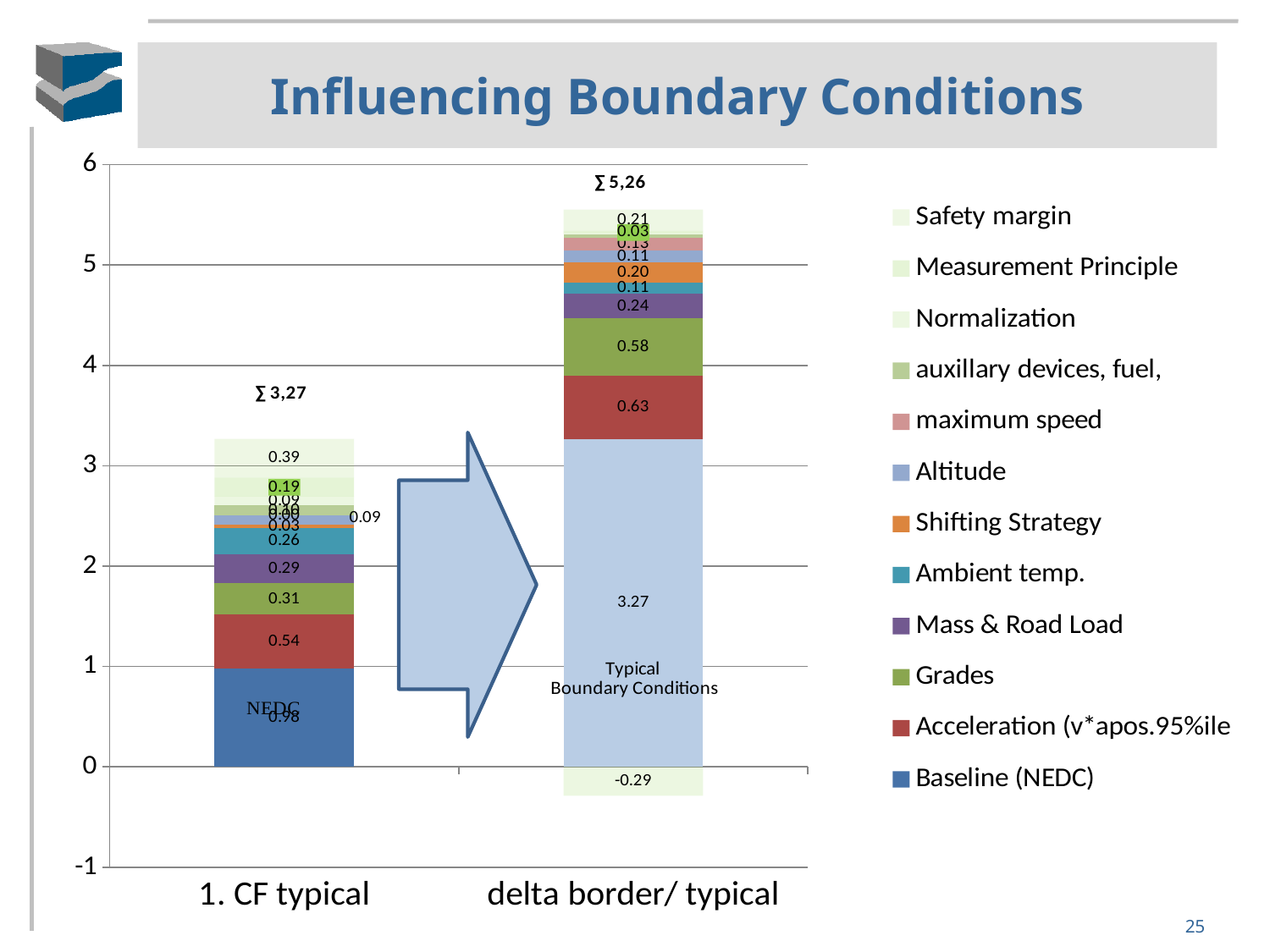
What is the difference between the Grades segment in the "delta border/ typical" bar and the Grades segment in the "1. CF typical" bar? 0.27 What is the value of the Baseline (NEDC) segment in the "1. CF typical" bar? 0.98 What is the value of the Grades segment in the "delta border/ typical" bar? 0.58 What is the value of the Acceleration segment in the "1. CF typical" bar? 0.54 What is the value of the Safety margin segment in the "1. CF typical" bar? 0.39 How many bars (categories) are shown on the x axis? 2 What is the total shown above the "1. CF typical" bar? ∑ 3,27 What is the total shown above the "delta border/ typical" bar? ∑ 5,26 How many series does the legend list? 12 What kind of chart is shown on the slide? Stacked bar chart What is the value of the Acceleration segment in the "delta border/ typical" bar? 0.63 Which bar has the larger total, "1. CF typical" or "delta border/ typical"? delta border/ typical